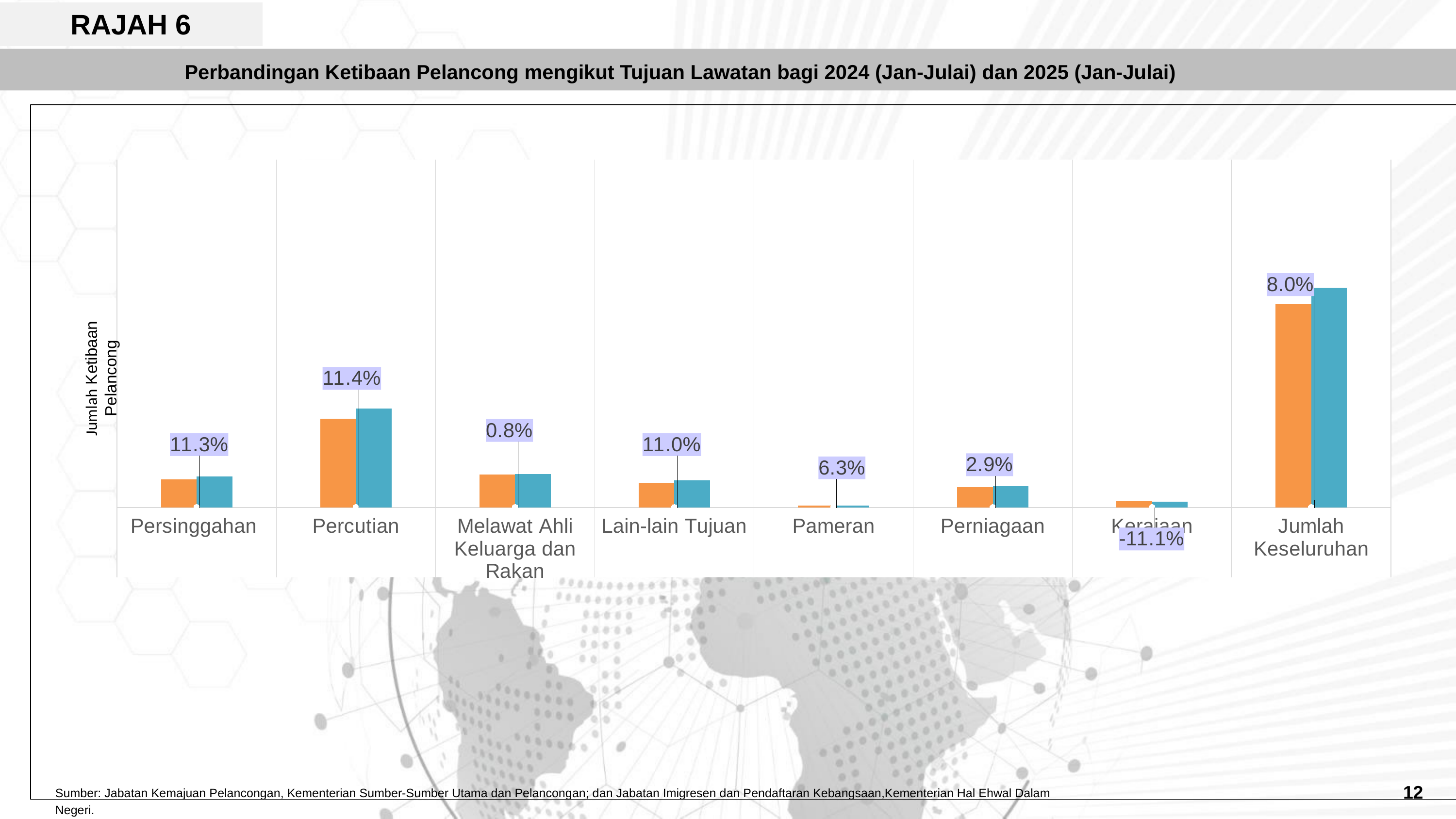
What percentage change is labelled for Kerajaan? -11.1% Which category has the highest labelled percentage change? Percutian How many categories are shown on the x axis of the chart? 8 Which category has the tallest bars in the chart? Jumlah Keseluruhan What percentage change is labelled for Jumlah Keseluruhan? 8.0% What is the label on the vertical axis of the chart? Jumlah Ketibaan Pelancong What is the difference in percentage points between the labelled change for Percutian and for Melawat Ahli Keluarga dan Rakan? 10.6 percentage points Which category has taller bars, Percutian or Persinggahan? Percutian Which category has the lowest labelled percentage change? Kerajaan What kind of chart is shown on the slide? bar chart What percentage change is labelled for Percutian? 11.4% What percentage change is labelled for Melawat Ahli Keluarga dan Rakan? 0.8%